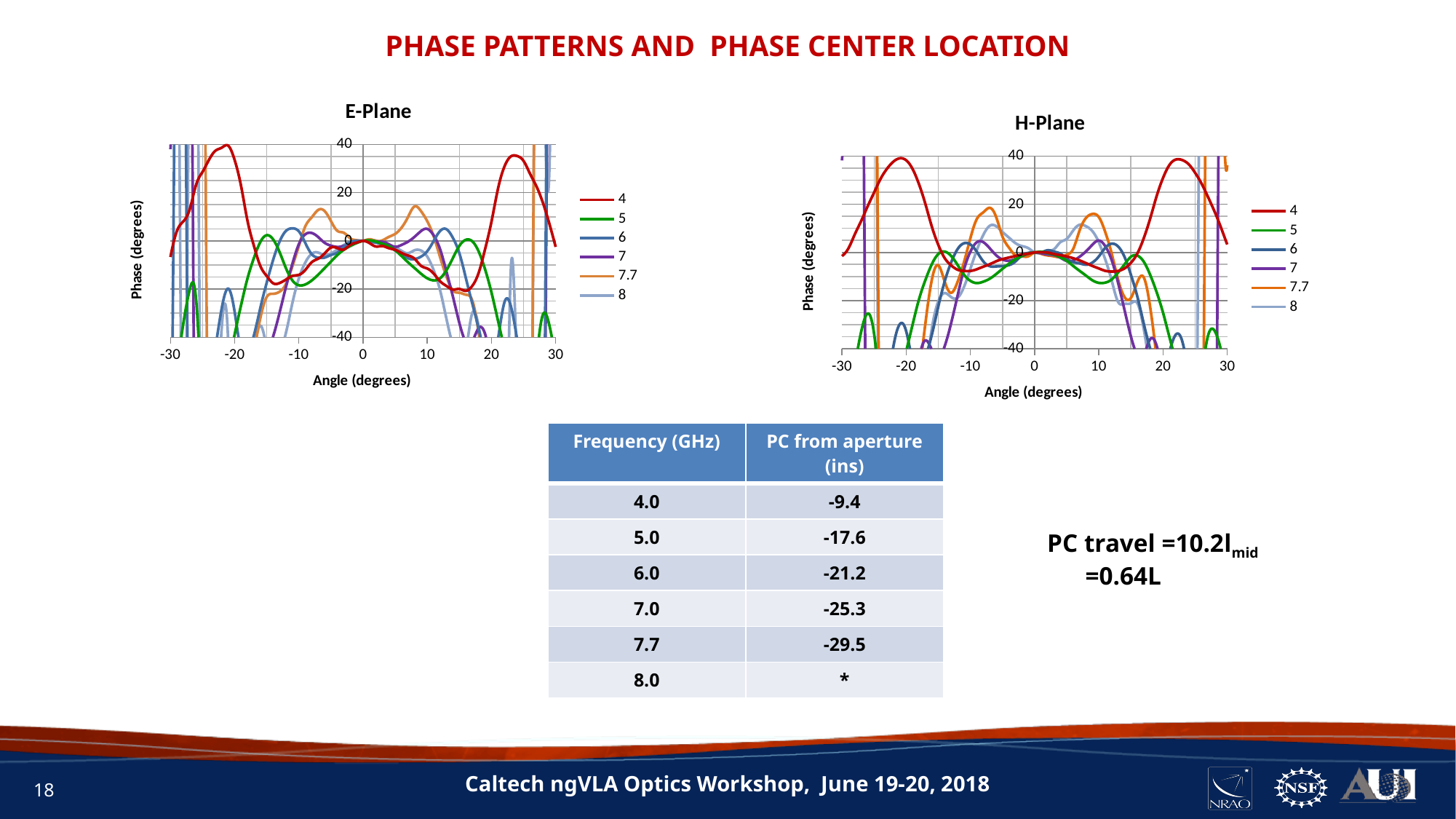
In the E-Plane chart, which series reaches the highest phase value within the plotted range, series 4 or series 5? 4 What kind of chart is the H-Plane chart? line chart How many series does the legend of the E-Plane chart list? 6 In the E-Plane chart, is the peak value of series 7.7 near an angle of 8 degrees greater or less than 20? less In the E-Plane chart, is the value of series 4 at an angle of 10 degrees greater or less than 0? less What kind of chart is the E-Plane chart? line chart In the E-Plane chart, is the peak value of series 4 near an angle of -20 degrees greater or less than 20? greater How many series does the legend of the H-Plane chart list? 6 In the H-Plane chart, what is the title of the x axis? Angle (degrees) In the E-Plane chart, what is the title of the y axis? Phase (degrees)